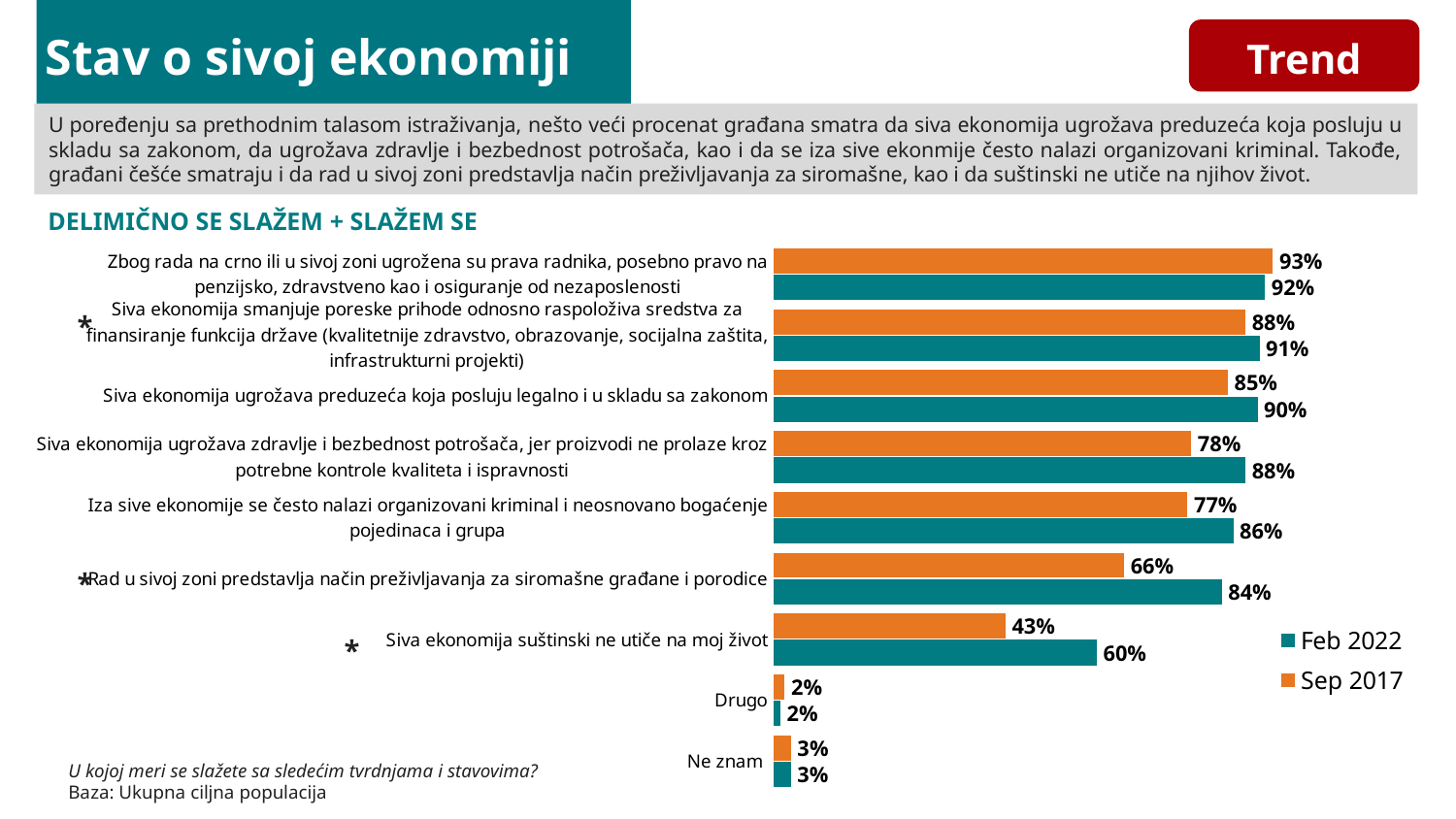
What is the difference between the Feb 2022 and Sep 2017 values for "Siva ekonomija suštinski ne utiče na moj život"? 17 percentage points What is the difference between the Feb 2022 and Sep 2017 values for "Siva ekonomija ugrožava zdravlje i bezbednost potrošača, jer proizvodi ne prolaze kroz potrebne kontrole kvaliteta i ispravnosti"? 10 percentage points How many series does the legend list? 2 Which statement has the highest Sep 2017 value? Zbog rada na crno ili u sivoj zoni ugrožena su prava radnika, posebno pravo na penzijsko, zdravstveno kao i osiguranje od nezaposlenosti What kind of chart is shown on the slide? Bar chart What is the Feb 2022 value for "Siva ekonomija ugrožava preduzeća koja posluju legalno i u skladu sa zakonom"? 90% For "Rad u sivoj zoni predstavlja način preživljavanja za siromašne građane i porodice", which is larger: the Feb 2022 value or the Sep 2017 value? Feb 2022 Which category has the lowest Feb 2022 value? Drugo What is the Feb 2022 value for "Siva ekonomija suštinski ne utiče na moj život"? 60% How many categories are shown in the chart? 9 What is the Sep 2017 value for "Iza sive ekonomije se često nalazi organizovani kriminal i neosnovano bogaćenje pojedinaca i grupa"? 77% What is the Sep 2017 value for "Rad u sivoj zoni predstavlja način preživljavanja za siromašne građane i porodice"? 66%